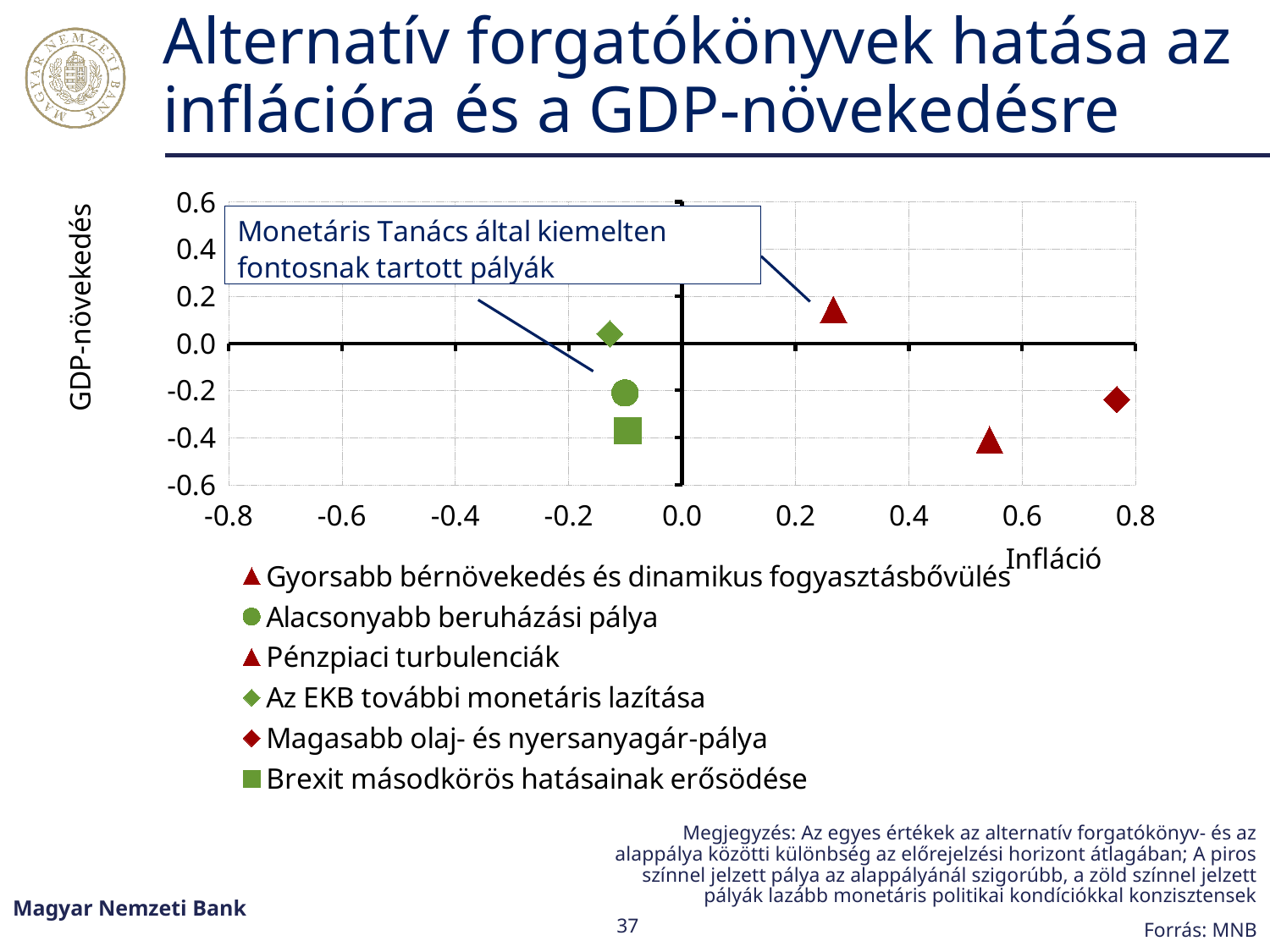
Is the GDP growth value for 'Brexit másodkörös hatásainak erősödése' greater or less than -0.2? less Which series has the highest inflation value (furthest right on the x axis)? Magasabb olaj- és nyersanyagár-pálya Is the GDP growth value for 'Magasabb olaj- és nyersanyagár-pálya' greater or less than 0.0? less Is the inflation value for 'Az EKB további monetáris lazítása' greater or less than 0.0? less What is the label of the vertical axis? GDP-növekedés How many data points are plotted on the chart? 6 What kind of chart is shown on the slide? scatter chart How many series does the legend list? 6 What is the label of the horizontal axis? Infláció Which has the higher GDP growth value, 'Alacsonyabb beruházási pálya' or 'Brexit másodkörös hatásainak erősödése'? Alacsonyabb beruházási pálya